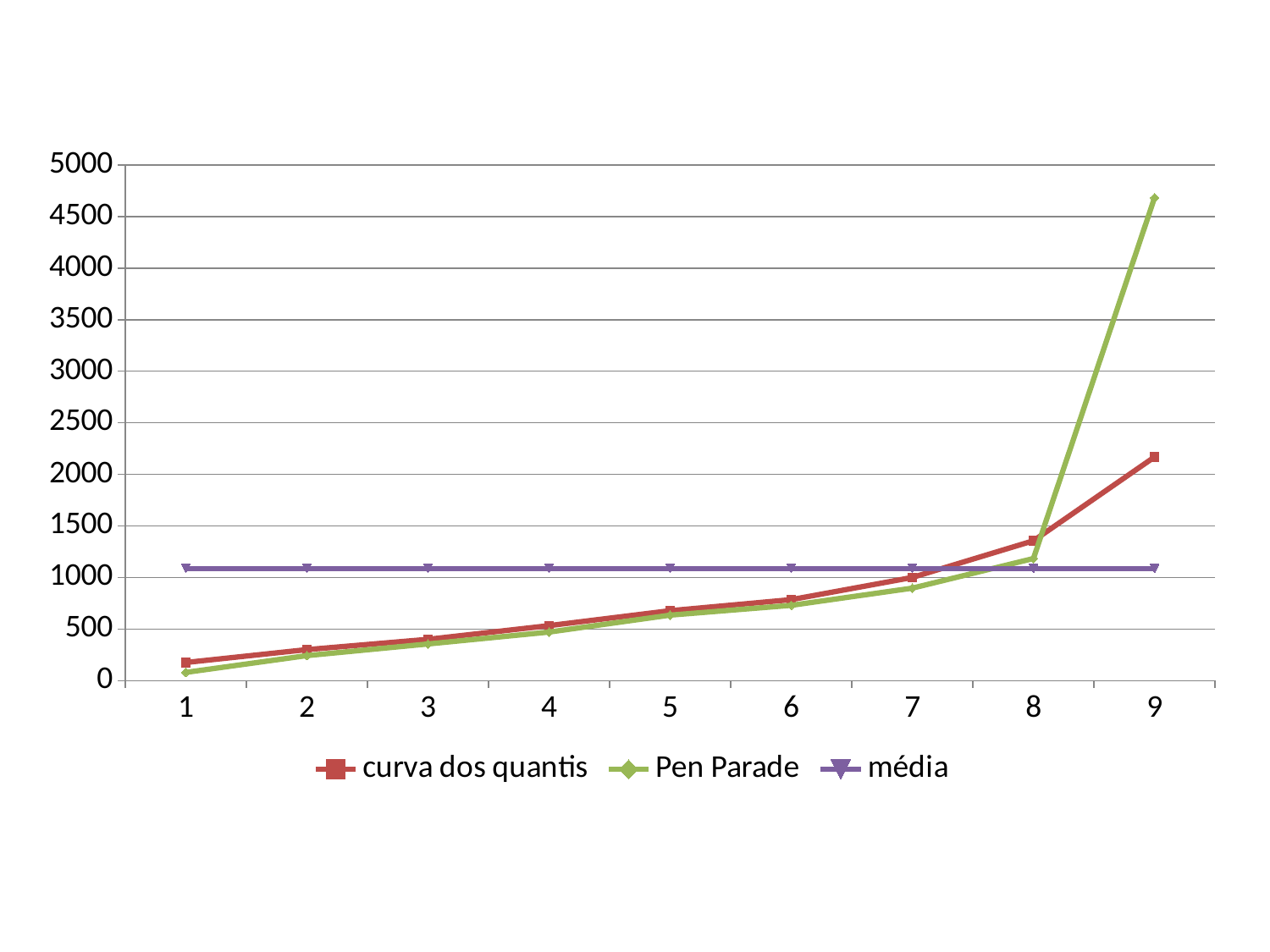
What kind of chart is shown on the slide? line chart Is the value of the média line greater or less than 1000? greater What colour is the média line? purple At x = 9, which series is higher: Pen Parade or curva dos quantis? Pen Parade At which x value does Pen Parade reach its highest point? 9 How many series does the legend list? 3 At which x value is curva dos quantis lowest? 1 Do the values of curva dos quantis rise or fall from x = 1 to x = 9? rise Is the value of Pen Parade at x = 9 greater or less than 4500? greater Is the value of curva dos quantis at x = 9 greater or less than 2000? greater How many points are plotted along the x axis for each series? 9